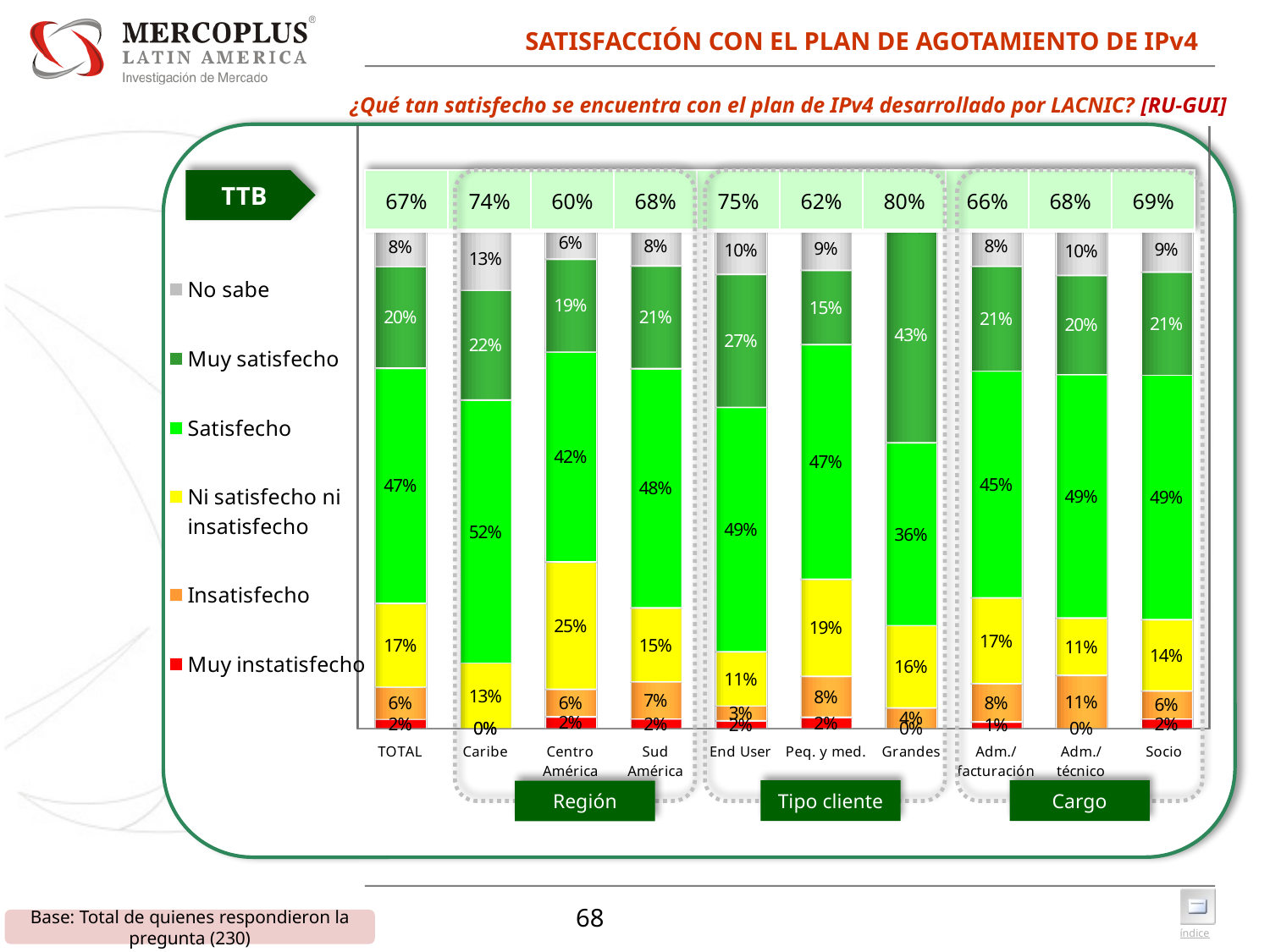
What is the 'Satisfecho' value for Caribe? 52% Which category has the highest TTB value? Grandes What is the difference between the 'Satisfecho' values for Caribe and Grandes? 16% Which category has the lowest TTB value? Centro América What is the 'Muy satisfecho' value for Grandes? 43% What is the TTB value shown for End User? 75% How many series does the legend list? 6 What is the 'Ni satisfecho ni insatisfecho' value for Centro América? 25% How many categories are shown along the x axis? 10 What kind of chart is shown on the slide? Stacked bar chart Which is larger, the 'Muy satisfecho' value for End User or for Peq. y med.? End User What is the 'Insatisfecho' value for Adm./técnico? 11%